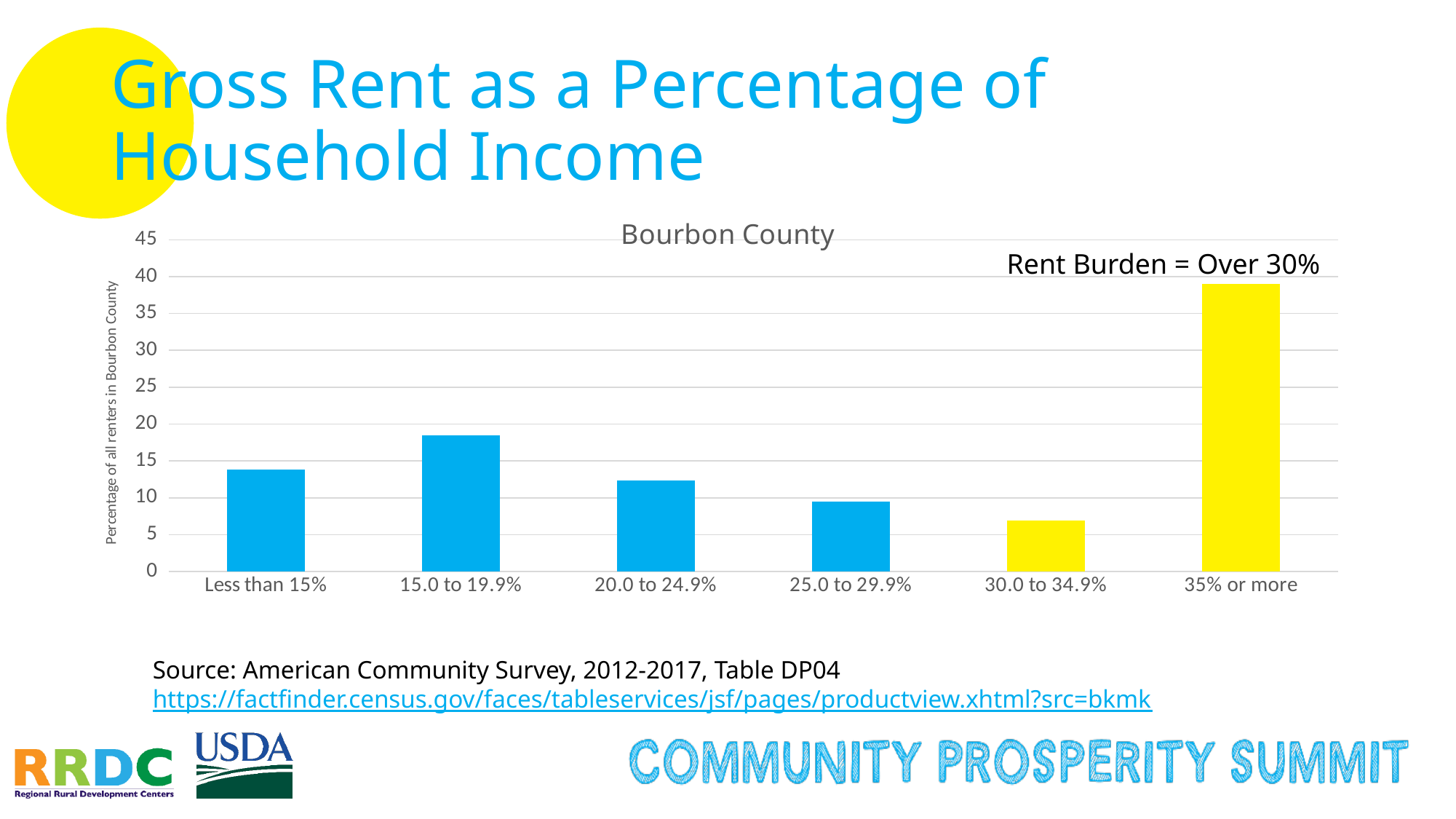
Is the value for 20.0 to 24.9% greater or less than 10? greater Which category has the highest value in the chart? 35% or more What type of chart is shown on the slide? Bar chart Which is larger, the value for 15.0 to 19.9% or the value for Less than 15%? 15.0 to 19.9% Is the value for 15.0 to 19.9% greater or less than 15? greater Which category has the lowest value in the chart? 30.0 to 34.9% What is the title of the chart? Bourbon County Which categories are shown with yellow bars in the chart? 30.0 to 34.9% and 35% or more How many categories are shown on the x axis of the chart? 6 Is the value for 30.0 to 34.9% greater or less than 10? less Which is larger, the value for 20.0 to 24.9% or the value for 35% or more? 35% or more